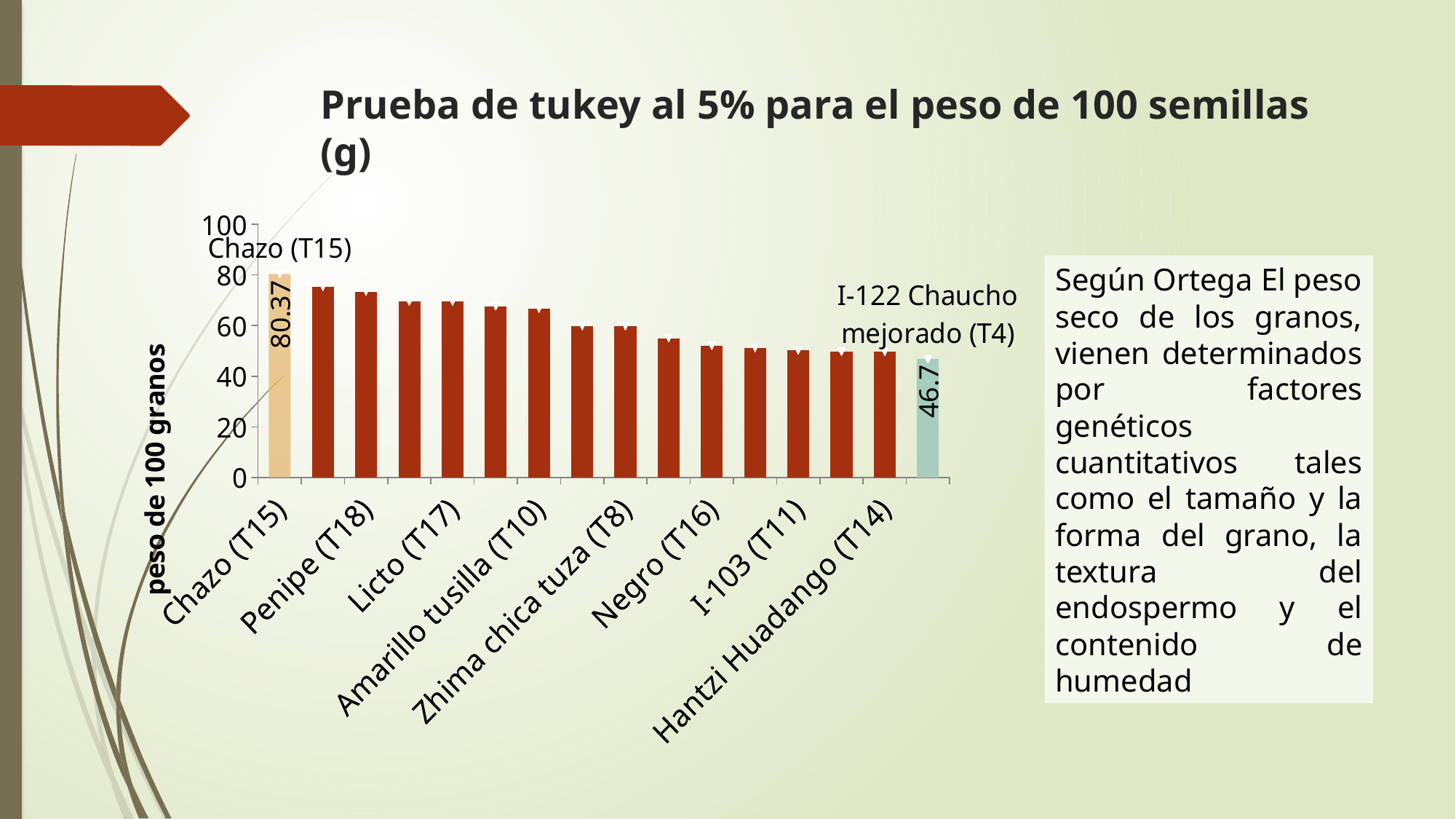
How many bars are plotted in the chart? 16 What is the value for I-122 Chaucho mejorado (T4)? 46.7 Is the value for Hantzi Huadango (T14) greater or less than 60? less Is the value for Licto (T17) greater or less than 60? greater Which category has the lowest value? I-122 Chaucho mejorado (T4) Is the value for Penipe (T18) greater or less than 60? greater What kind of chart is shown on the slide? bar chart Which category has the highest value? Chazo (T15) Do the values rise or fall from left to right along the x axis? fall Which is larger, the value for Penipe (T18) or the value for Negro (T16)? Penipe (T18) What is the value for Chazo (T15)? 80.37 What is the difference between the values for Chazo (T15) and I-122 Chaucho mejorado (T4)? 33.67